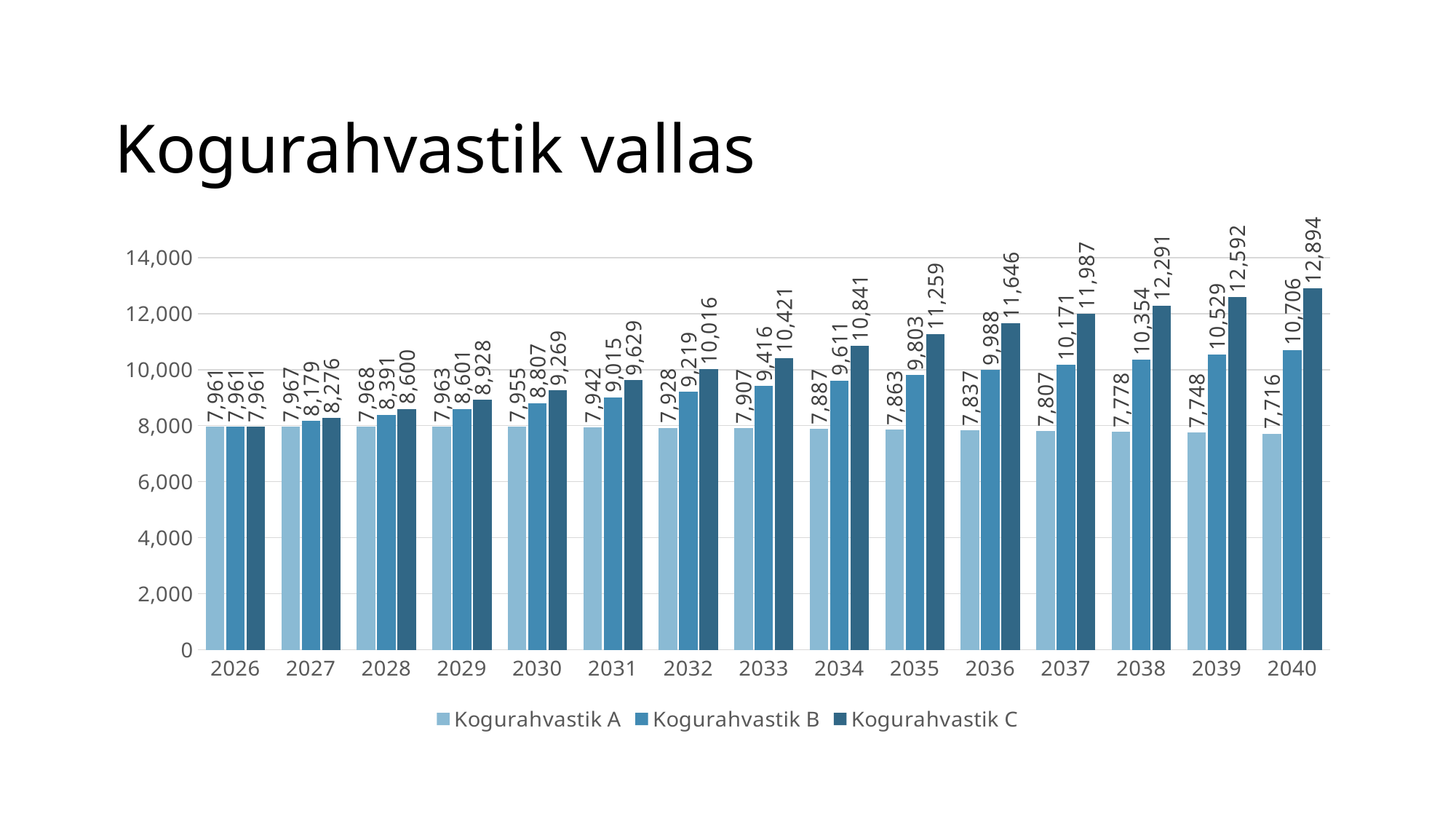
In which year is Kogurahvastik C highest? 2040 What kind of chart is shown on the slide? Bar chart What is the value for Kogurahvastik C in 2040? 12,894 Does Kogurahvastik A rise or fall from 2026 to 2040? Fall Is the value for Kogurahvastik C in 2037 greater or less than 10,000? greater How many series does the legend list? 3 What is the value for Kogurahvastik A in 2026? 7,961 What is the difference between Kogurahvastik C and Kogurahvastik A in 2040? 5,178 In which year is Kogurahvastik A lowest? 2040 What is the value for Kogurahvastik B in 2033? 9,416 Which is larger in 2035: Kogurahvastik B or Kogurahvastik C? Kogurahvastik C How many years are shown on the x axis? 15